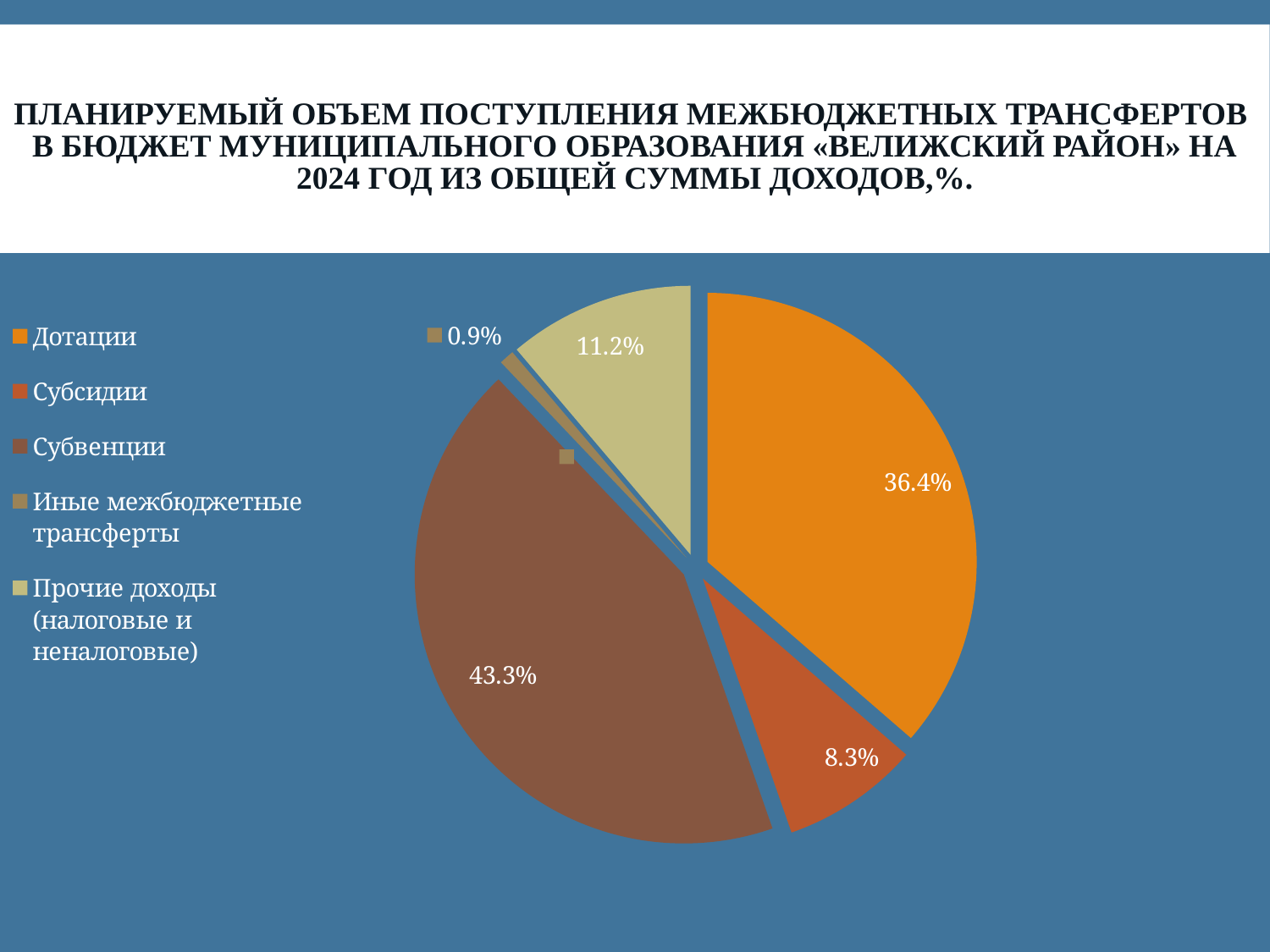
What colour is the slice for Дотации? orange What kind of chart is shown on the slide? pie chart What share of the pie does Дотации account for? 36.4% What is the difference between the values for Субвенции and Дотации? 6.9% What is the value shown for Субсидии? 8.3% What is the value shown for Иные межбюджетные трансферты? 0.9% What is the value shown for Субвенции? 43.3% What is the value shown for Прочие доходы (налоговые и неналоговые)? 11.2% Which category has the largest slice of the pie? Субвенции Which is larger, the slice for Субсидии or the slice for Прочие доходы (налоговые и неналоговые)? Прочие доходы (налоговые и неналоговые) How many categories does the legend list? 5 Which category has the smallest slice of the pie? Иные межбюджетные трансферты